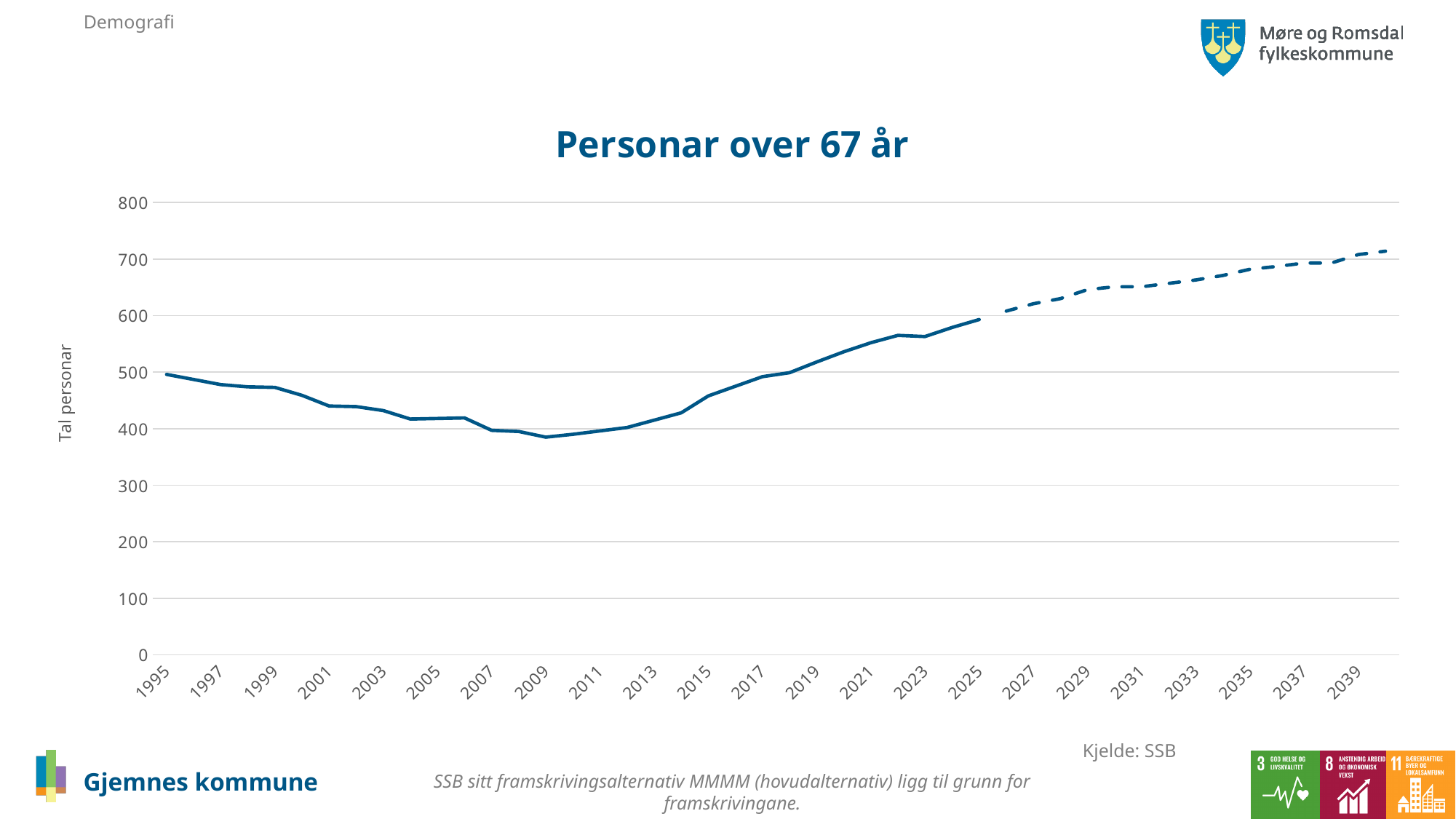
In which year does the line reach its lowest point? 2009 Is the value for 2021 greater or less than 500? greater Do the values rise or fall between 1995 and 2009? fall What kind of chart is shown on the slide? Line chart What is the label on the vertical axis of the chart? Tal personar Do the values rise or fall between 2009 and 2039? rise Is the value for 2001 greater or less than 500? less Is the value for 2029 greater or less than 600? greater What is the title of the chart? Personar over 67 år